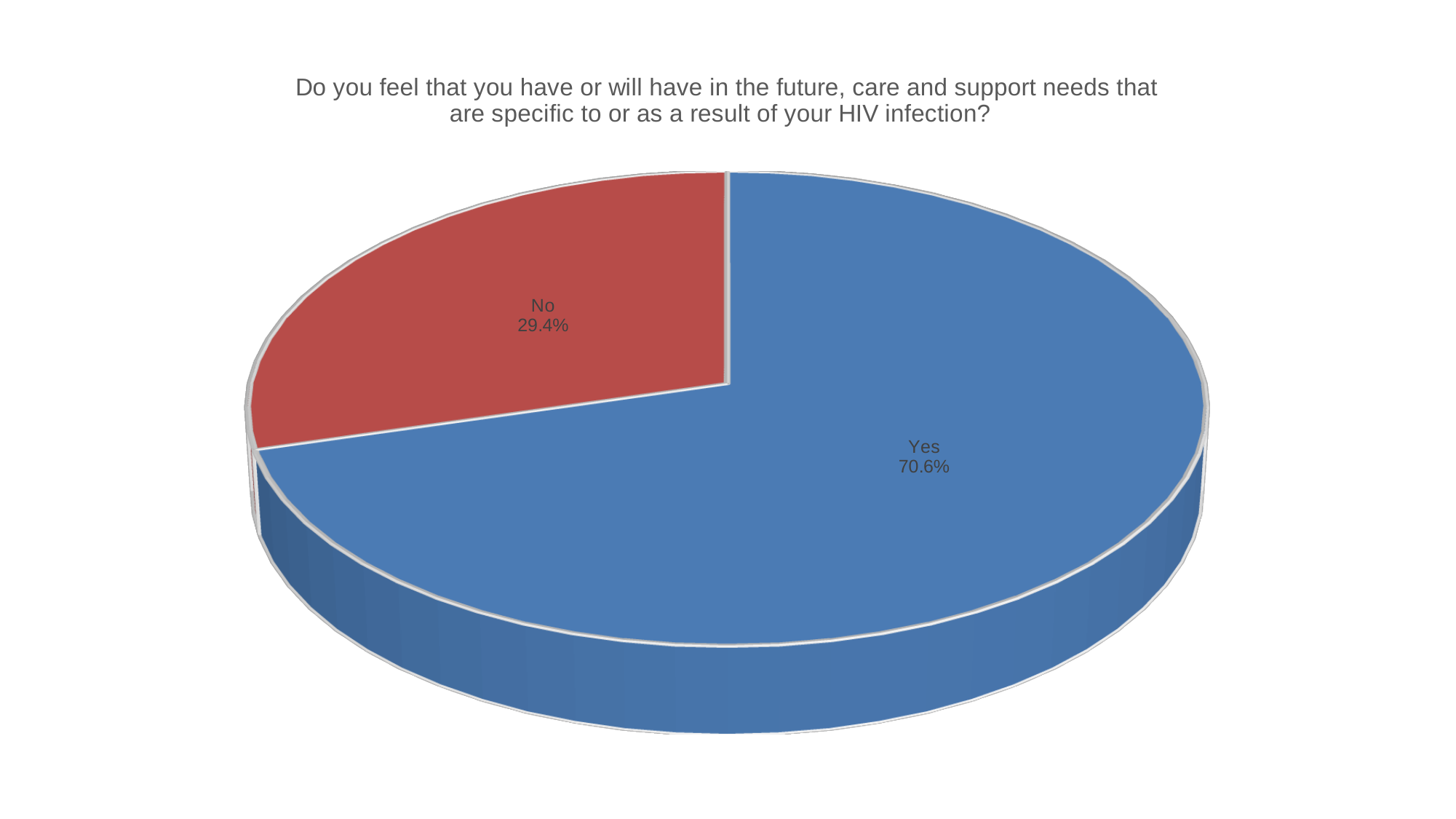
What is the difference in percentage points between the "Yes" and "No" slices? 41.2 Which is larger, the "Yes" slice or the "No" slice? Yes What percentage of respondents answered "Yes"? 70.6% What percentage of respondents answered "No"? 29.4% How many slices does the pie chart have? 2 Which response has the smallest share of the pie? No What share of the pie does the "No" slice represent? 29.4% What colour is the "Yes" slice? Blue Which response has the largest share of the pie? Yes What kind of chart is shown on the slide? Pie chart What colour is the "No" slice? Red